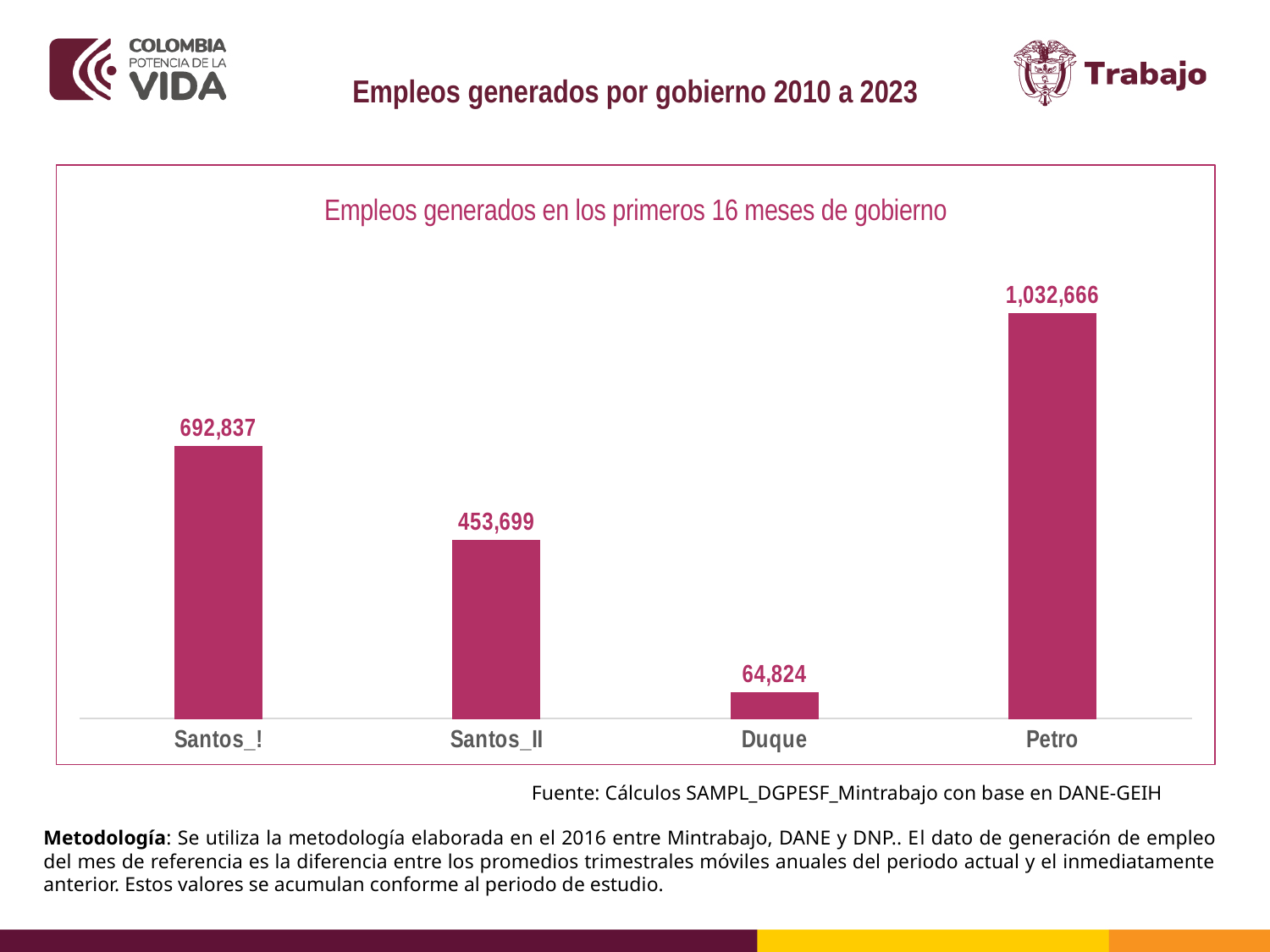
What is the value for Duque? 64,824 What is the difference between the values for Santos_! and Santos_II? 239,138 What is the value for Petro? 1,032,666 What is the value for Santos_!? 692,837 What kind of chart is shown? Bar chart What is the title of the chart? Empleos generados en los primeros 16 meses de gobierno Which government has the lowest value? Duque What is the difference between the values for Petro and Santos_!? 339,829 What is the value for Santos_II? 453,699 How many governments are shown in the chart? 4 Which government has the highest value? Petro Which is larger, the value for Santos_II or the value for Duque? Santos_II